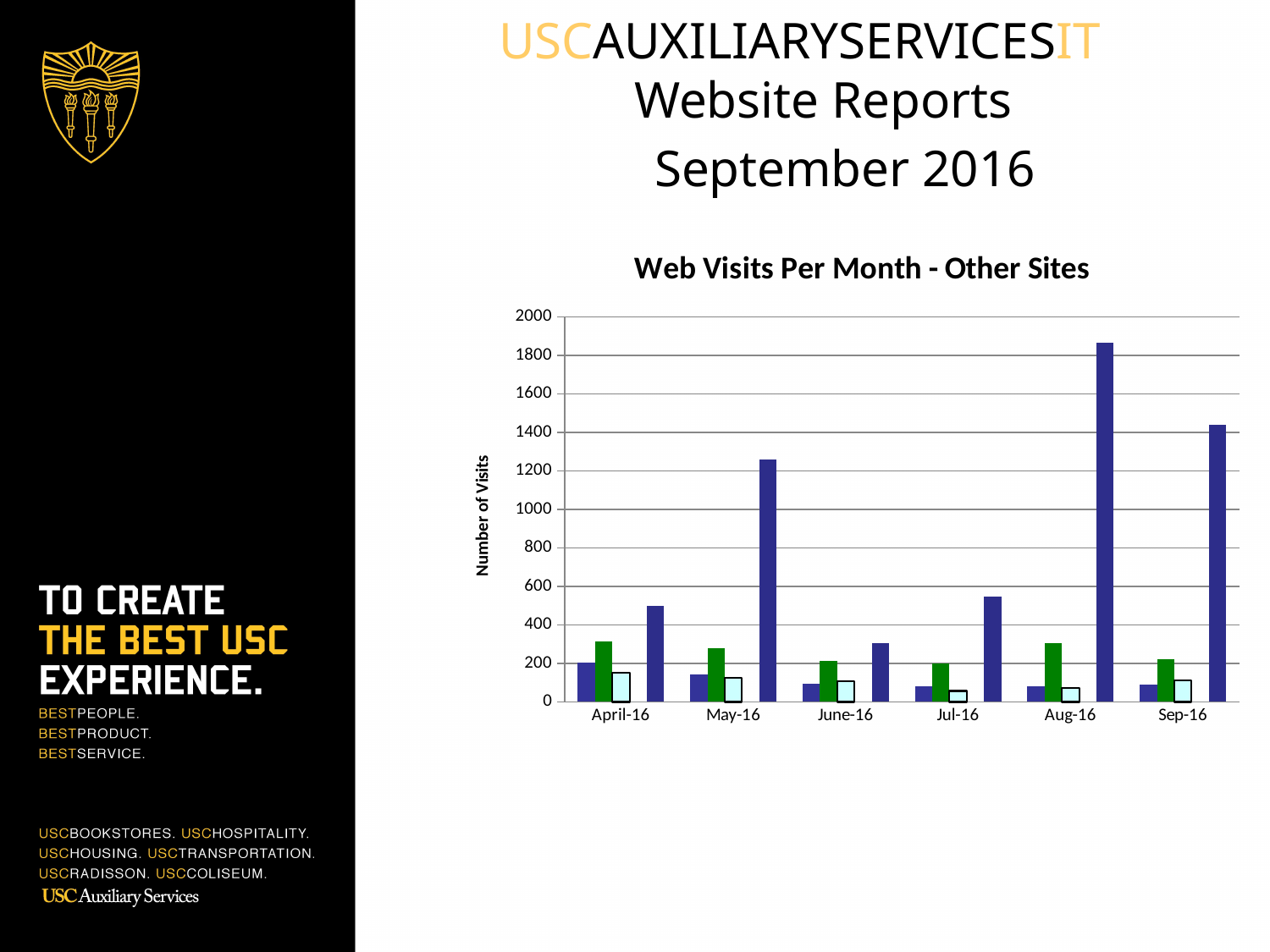
How many bars are plotted for each month in the chart? 4 Is the tallest bar for Sep-16 greater or less than 1200? greater How many months are shown on the x axis of the chart? 6 Is the tallest bar for Aug-16 greater or less than 1600? greater What kind of chart is shown on the slide? bar chart In which month does the chart's tallest bar appear? Aug-16 What is the label on the vertical axis of the chart? Number of Visits Which month has the taller tallest bar, Aug-16 or Sep-16? Aug-16 Is the tallest bar for May-16 greater or less than 1000? greater What is the title of the chart? Web Visits Per Month - Other Sites Which month has the taller tallest bar, May-16 or Jul-16? May-16